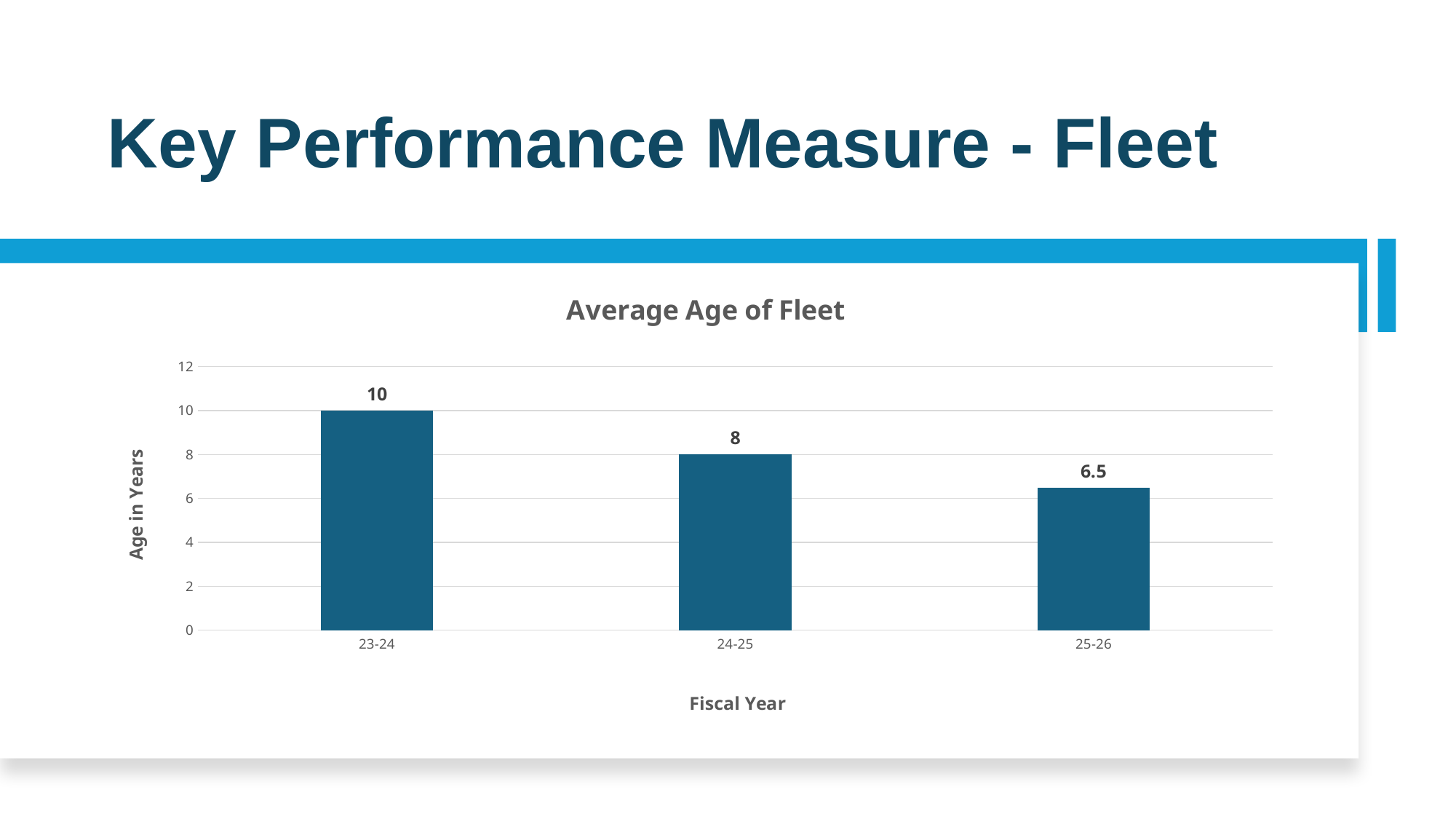
What is the average age of fleet for fiscal year 23-24? 10 Which fiscal year has the highest average age of fleet? 23-24 Does the average age of fleet rise or fall across the fiscal years shown? Fall What is the difference in average fleet age between fiscal years 23-24 and 25-26? 3.5 How many fiscal years are shown in the chart? 3 What is the difference in average fleet age between fiscal years 23-24 and 24-25? 2 Is the average age of fleet for 25-26 greater or less than 8? less Which fiscal year has the lowest average age of fleet? 25-26 What is the average age of fleet for fiscal year 25-26? 6.5 Which fiscal year has a larger average fleet age, 24-25 or 25-26? 24-25 What type of chart is used to show the average age of fleet? Bar chart What is the average age of fleet for fiscal year 24-25? 8